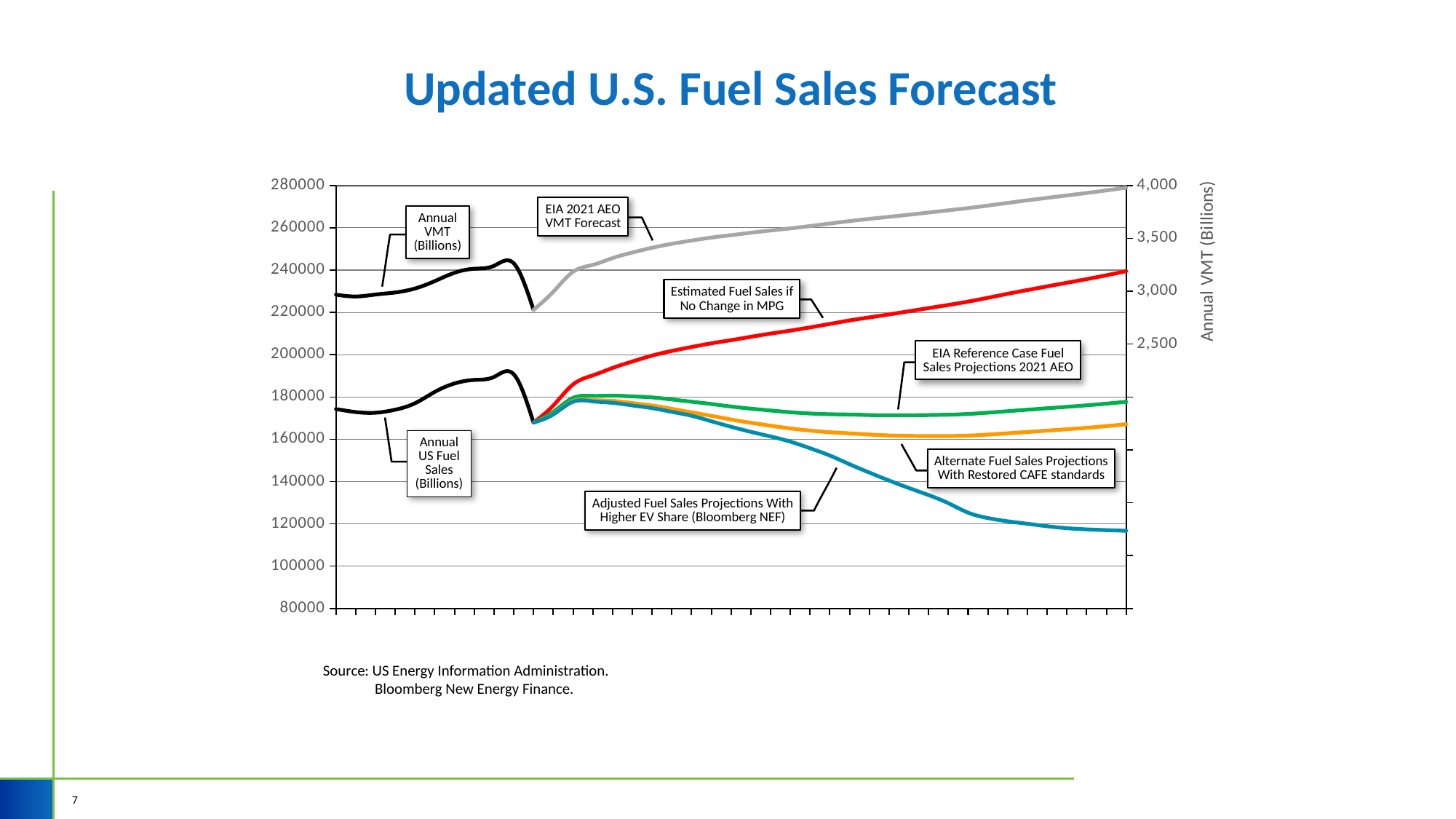
At the right edge of the chart, is the 'Adjusted Fuel Sales Projections With Higher EV Share (Bloomberg NEF)' value greater or less than 120000? less Which fuel sales projection line ends highest at the right edge of the chart? Estimated Fuel Sales if No Change in MPG At the right edge of the chart, which is higher: the 'EIA Reference Case Fuel Sales Projections 2021 AEO' line or the 'Alternate Fuel Sales Projections With Restored CAFE standards' line? EIA Reference Case Fuel Sales Projections 2021 AEO Does the 'Adjusted Fuel Sales Projections With Higher EV Share (Bloomberg NEF)' line rise or fall over the forecast period? fall At the right edge of the chart, is the 'Estimated Fuel Sales if No Change in MPG' value greater or less than 220000? greater Does the 'Estimated Fuel Sales if No Change in MPG' line rise or fall over the forecast period? rise Does the 'EIA 2021 AEO VMT Forecast' line rise or fall along the x axis? rise Which fuel sales projection line ends lowest at the right edge of the chart? Adjusted Fuel Sales Projections With Higher EV Share (Bloomberg NEF) What kind of chart is shown on the slide? line chart How many labeled series (lines) are shown on the chart? 7 What is the title of the chart on the slide? Updated U.S. Fuel Sales Forecast What is the label of the right-hand vertical axis? Annual VMT (Billions)